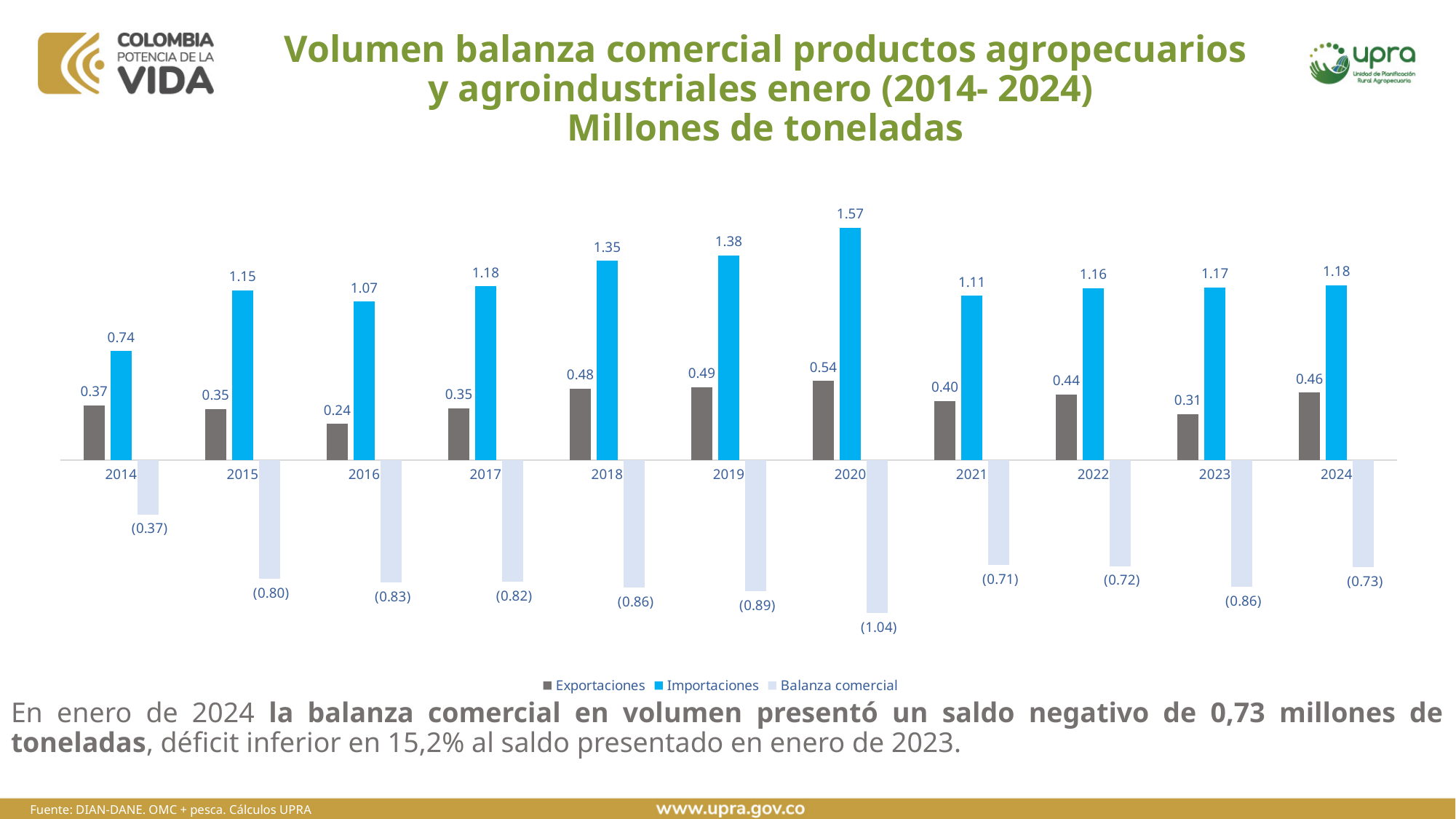
What kind of chart is shown on the slide? Bar chart What is the difference between Importaciones and Exportaciones in 2024? 0.72 Did Importaciones rise or fall from 2014 to 2020? Rise How many years are shown on the x axis? 11 What is the value of Importaciones for 2020? 1.57 What is the Balanza comercial value shown for 2024? (0.73) In which year is Importaciones highest? 2020 How many series does the legend list? 3 What is the value of Exportaciones for 2016? 0.24 Which series is shown in light blue in the legend? Balanza comercial In which year is Exportaciones lowest? 2016 Which is larger, Exportaciones in 2020 or Exportaciones in 2023? Exportaciones in 2020